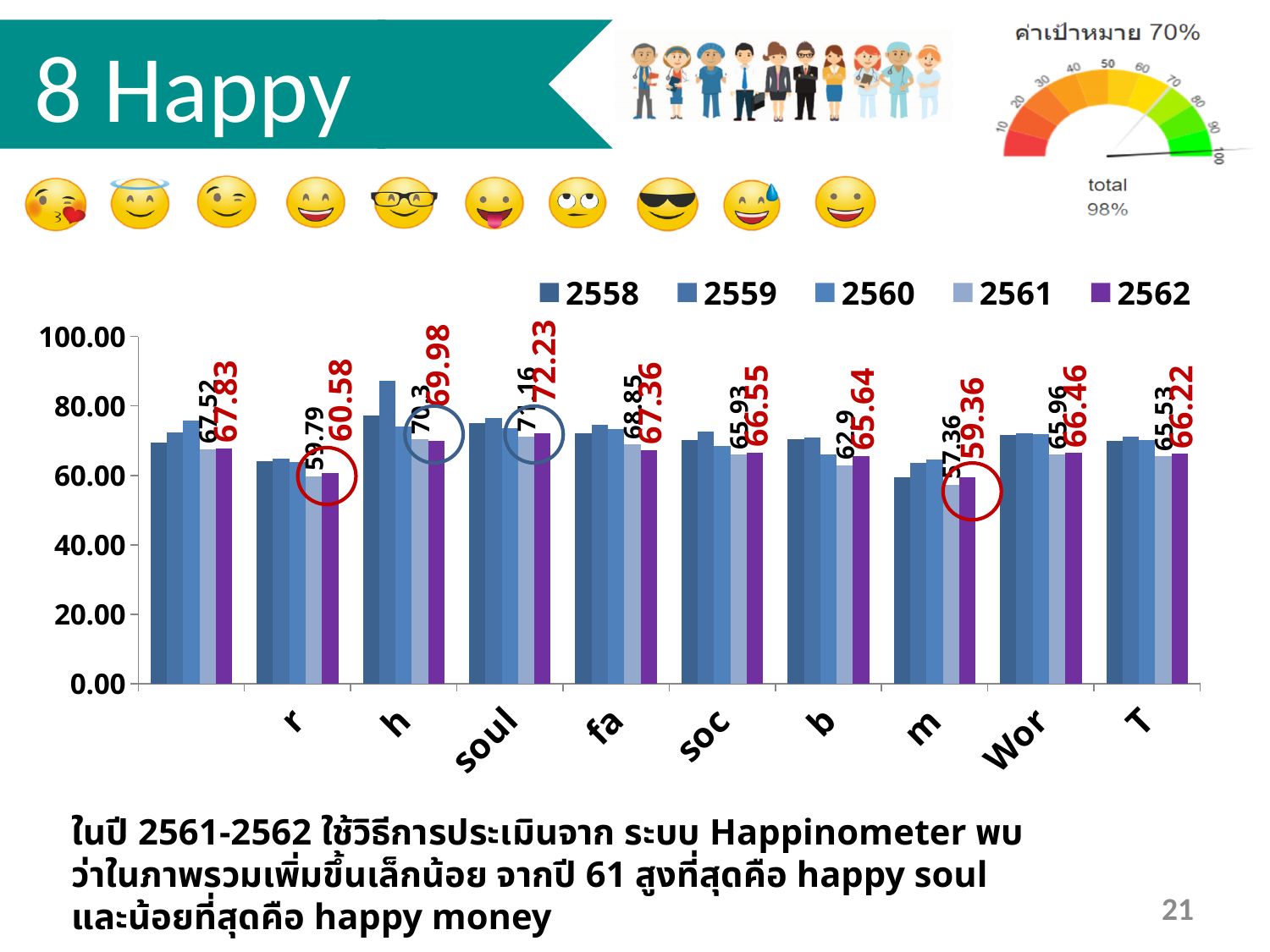
Which category has the highest 2562 value? soul What is the 2562 value for the category "soul"? 72.23 What is the 2561 value for the category "m"? 57.36 For the category "h", which is larger: the 2561 value or the 2562 value? 2561 What is the 2562 value for the category "T"? 66.22 Which year is listed first in the legend? 2558 Is the 2559 value for the category "h" greater or less than 80.00? greater What kind of chart is shown on the slide? bar chart What is the 2561 value for the category "Wor"? 65.96 What is the difference between the 2562 and 2561 values for "soul"? 1.07 How many series does the legend list? 5 Which category has the lowest 2562 value? m